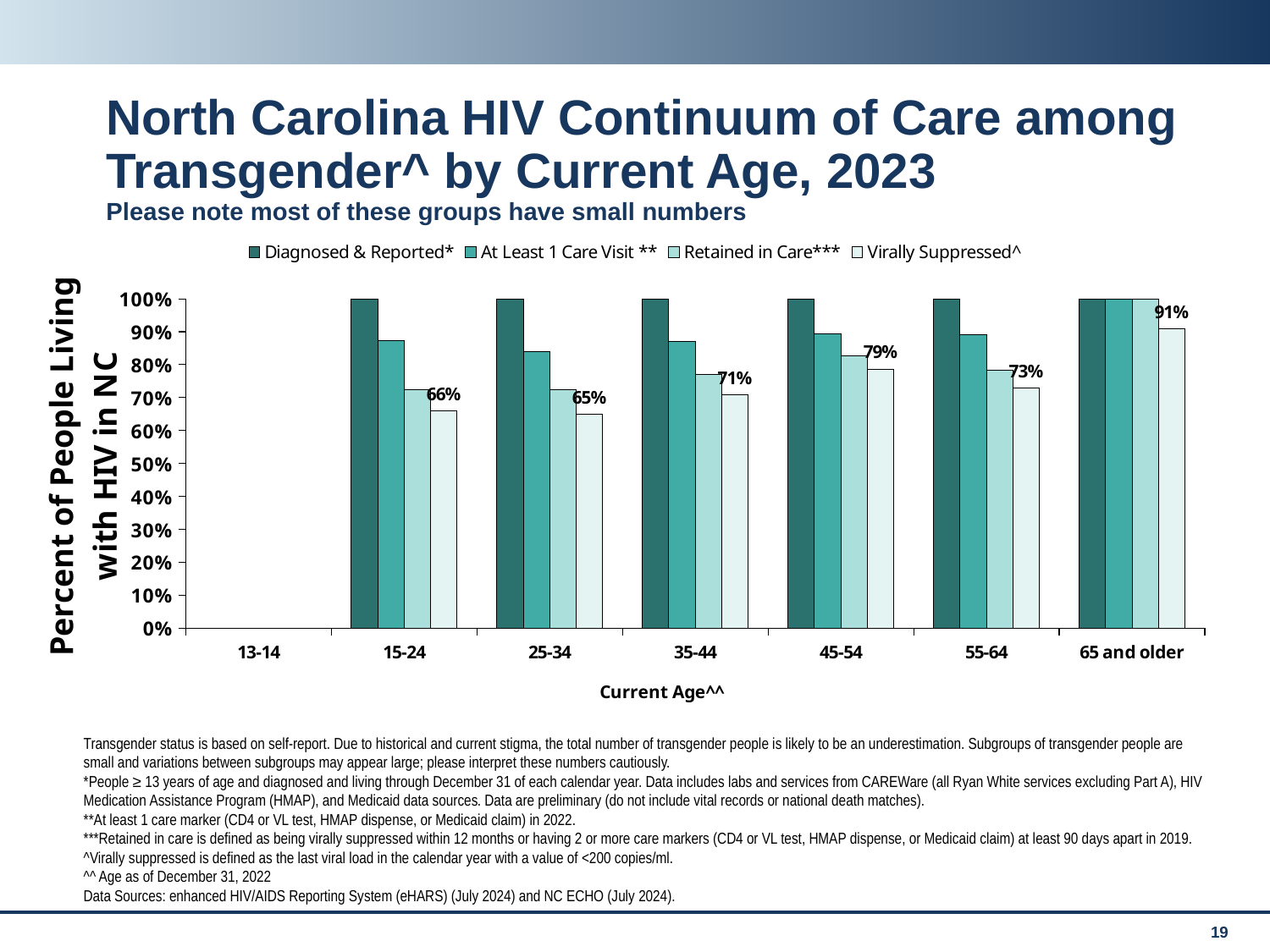
What is the difference between the Virally Suppressed values for the 45-54 and 35-44 age groups? 8% Is the At Least 1 Care Visit value for the 15-24 age group greater or less than 80%? greater How many age groups are shown on the x axis? 7 What is the Virally Suppressed value for the 15-24 age group? 66% Which age group has the highest Virally Suppressed value? 65 and older What kind of chart is shown on the slide? Bar chart What is the Virally Suppressed value for the 45-54 age group? 79% Which age group has the lowest Virally Suppressed value among those with data labels? 25-34 How many series does the legend list? 4 What is the Virally Suppressed value for the 65 and older age group? 91% Is the Retained in Care value for the 25-34 age group greater or less than 80%? less Which is larger, the Virally Suppressed value for 55-64 or for 25-34? 55-64